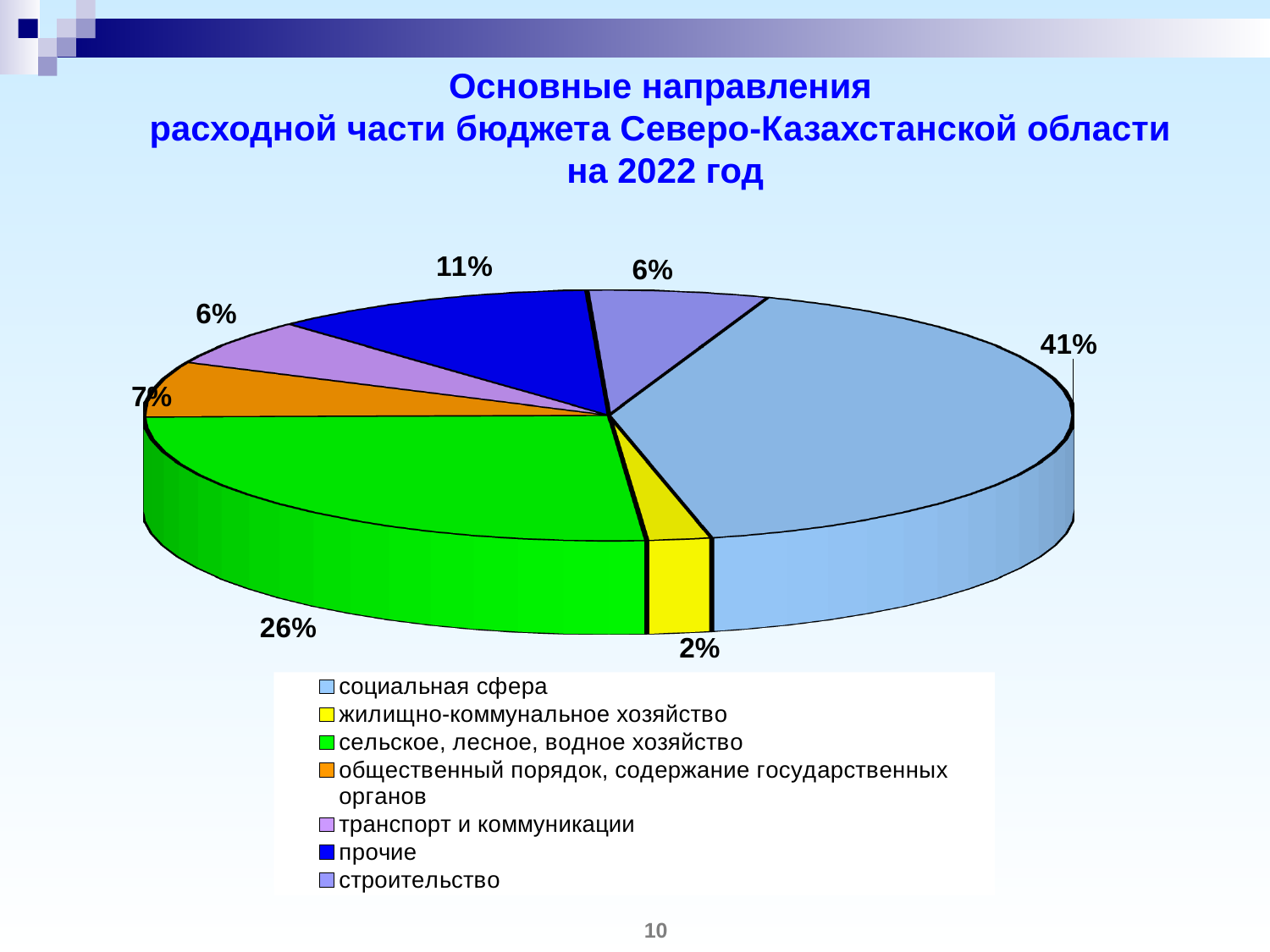
What is the difference in percentage points between социальная сфера and сельское, лесное, водное хозяйство? 15 Which category has the smallest share of the pie? жилищно-коммунальное хозяйство What share of the pie does сельское, лесное, водное хозяйство represent? 26% What share of the pie does общественный порядок, содержание государственных органов represent? 7% How many categories does the legend list? 7 What share of the pie does жилищно-коммунальное хозяйство represent? 2% Which colour represents сельское, лесное, водное хозяйство in the chart? green What kind of chart is shown on the slide? pie chart Which is larger: the share for прочие or the share for общественный порядок, содержание государственных органов? прочие Which category has the largest share of the pie? социальная сфера What share of the pie does прочие represent? 11% What share of the pie does социальная сфера represent? 41%